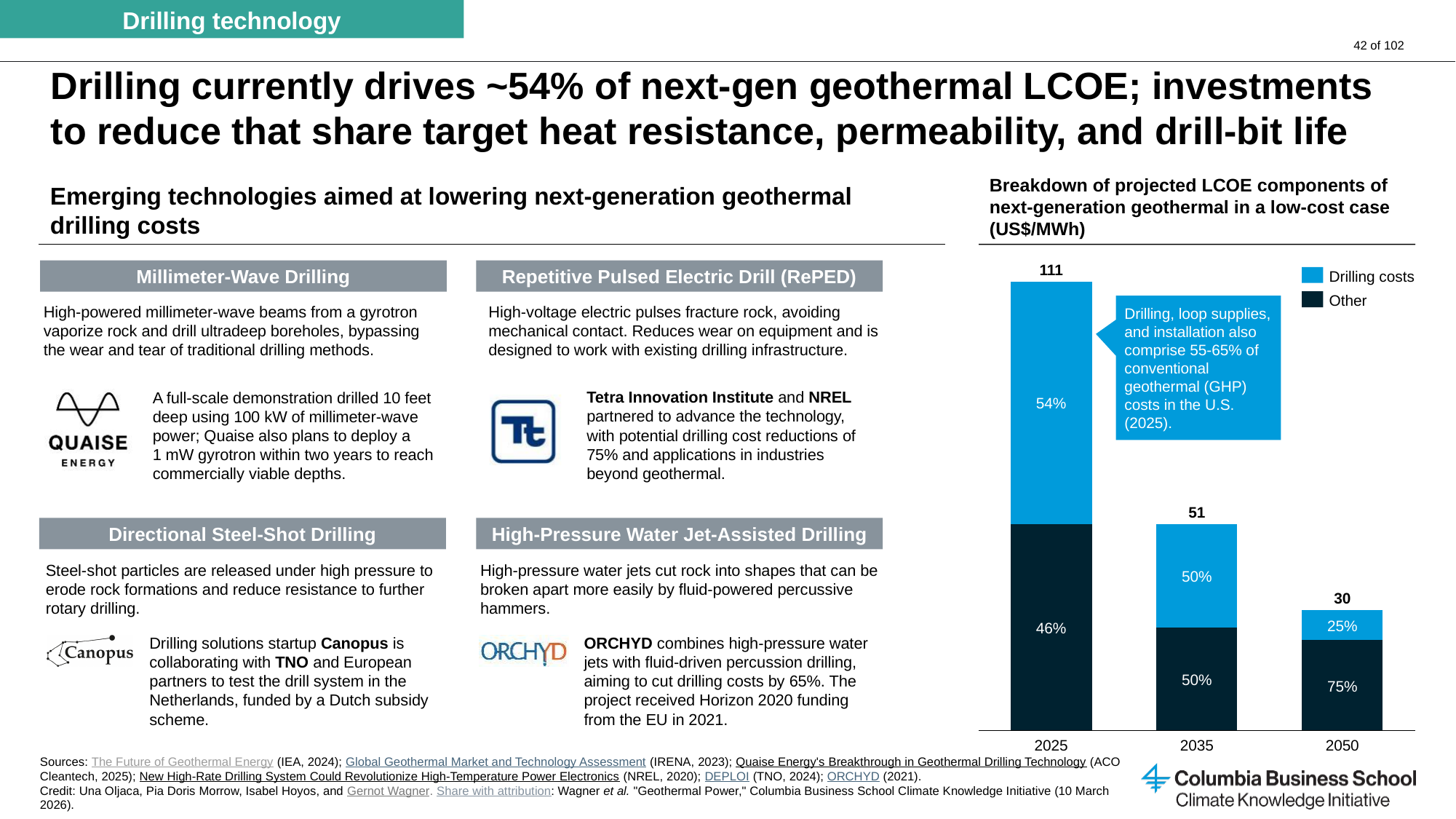
How many years are shown on the x axis of the chart? 3 How many series does the chart legend list? 2 What is the total projected LCOE for 2050 in the chart? 30 What is the difference between the total LCOE in 2025 and in 2035? 60 What share of the 2025 bar is drilling costs? 54% What is the total projected LCOE for 2025 in the chart? 111 Which year has the lowest total projected LCOE? 2050 Which year has the highest total projected LCOE? 2025 Does the total projected LCOE rise or fall from 2025 to 2050? fall Is the drilling costs share larger in 2025 or in 2050? 2025 What share of the 2035 bar is drilling costs? 50% What share of the 2050 bar is 'Other'? 75%